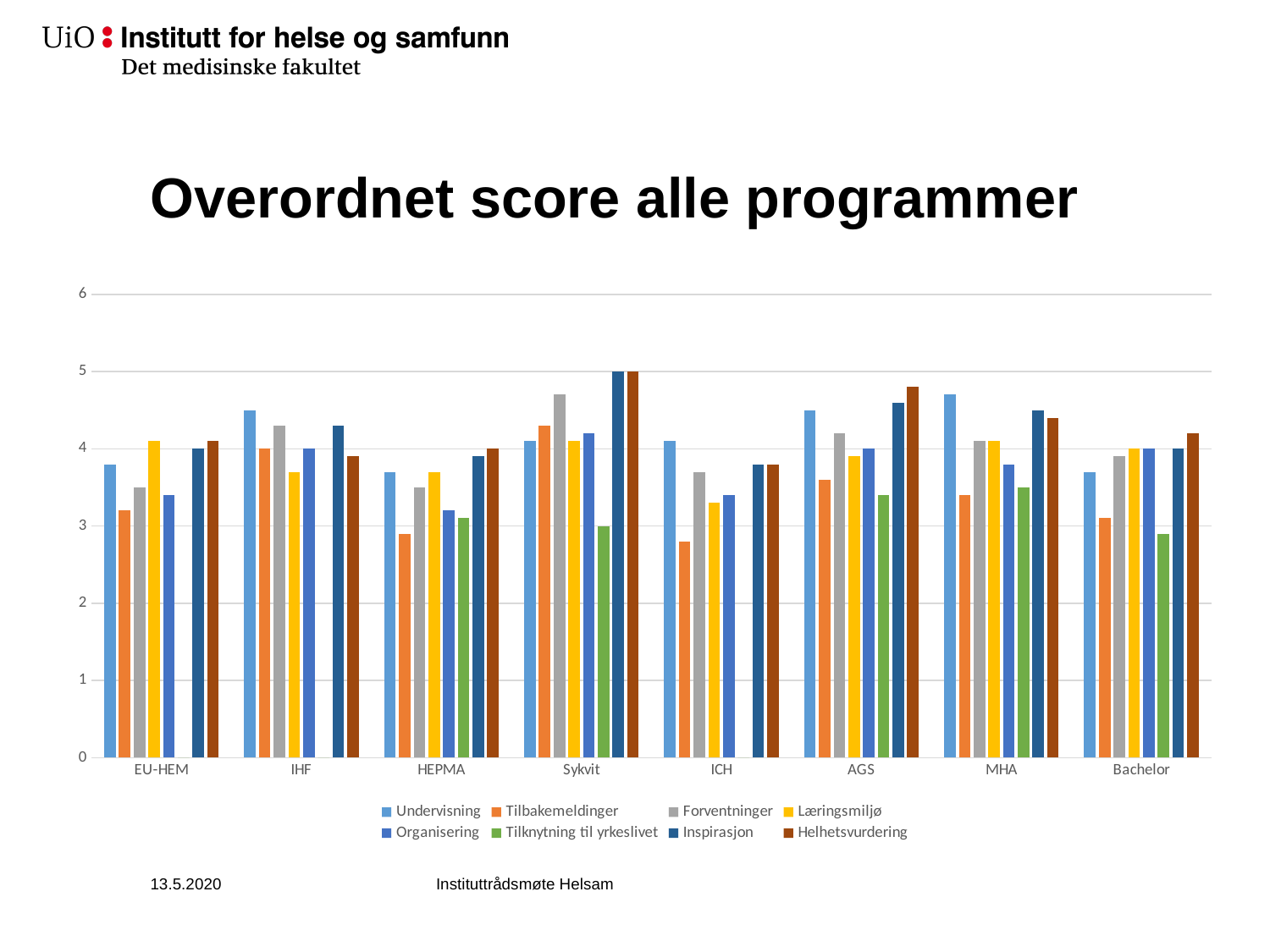
Which is larger for MHA: Undervisning or Tilbakemeldinger? Undervisning Is the value of Helhetsvurdering for AGS greater or less than 4? greater Which series has the lowest value for Sykvit? Tilknytning til yrkeslivet What is the title of the chart? Overordnet score alle programmer What is the value of Tilknytning til yrkeslivet for Sykvit? 3 Is the value of Tilbakemeldinger for EU-HEM greater or less than 4? less What is the value of Inspirasjon for Sykvit? 5 What kind of chart is shown on the slide? bar chart How many series does the legend list? 8 How many programmes (categories) are shown on the x axis? 8 Is the value of Undervisning for MHA greater or less than 4? greater